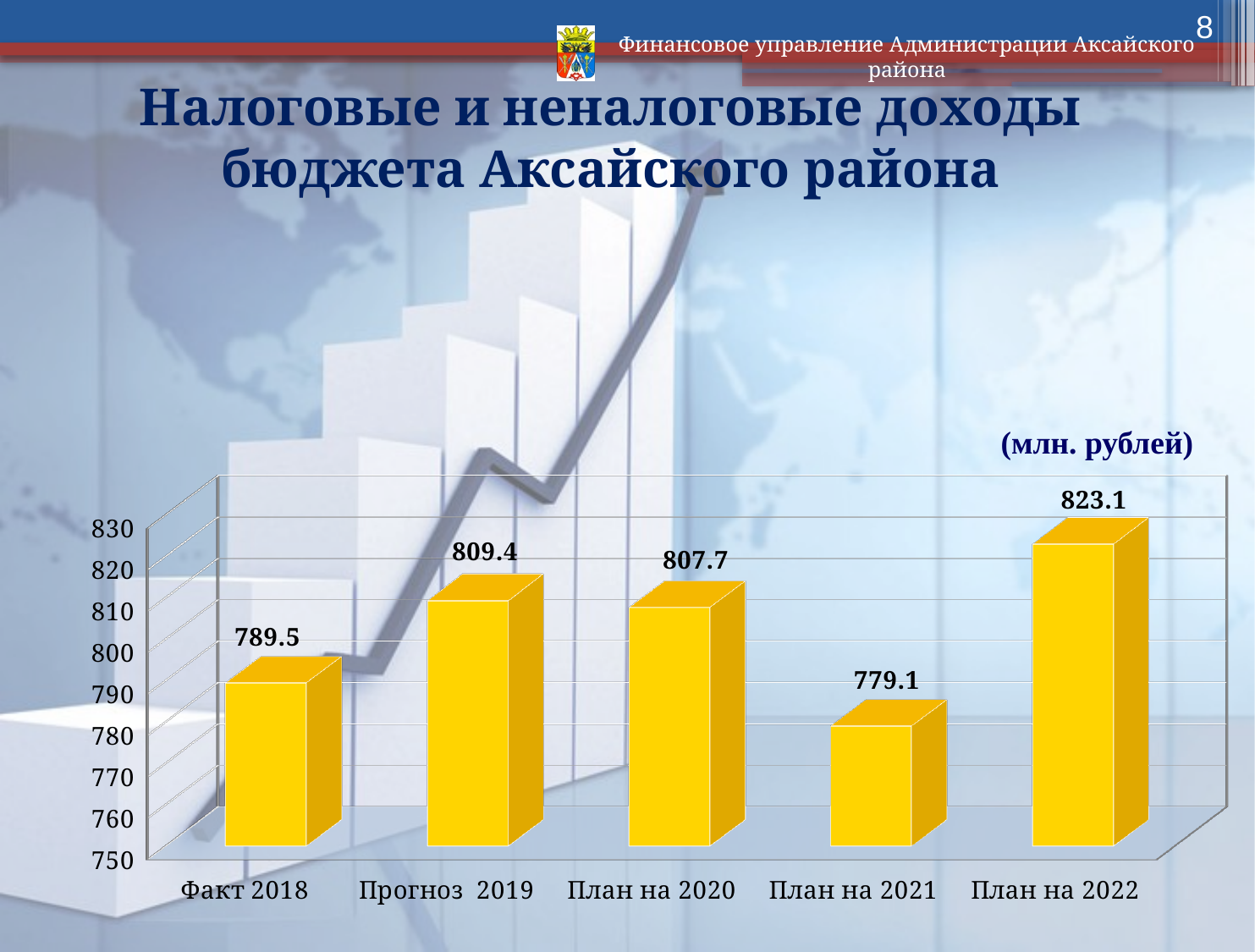
Which category has the highest value? План на 2022 Which category has the lowest value? План на 2021 Is the value for План на 2021 greater or less than 780? less What is the difference between the values for Прогноз 2019 and Факт 2018? 19.9 What is the difference between the values for План на 2022 and План на 2021? 44.0 What unit is indicated for the values on the chart? млн. рублей Which is larger, the value for Прогноз 2019 or the value for План на 2020? Прогноз 2019 What is the value for План на 2021? 779.1 What is the value for План на 2022? 823.1 What kind of chart is shown on the slide? bar chart What is the value for Факт 2018? 789.5 How many categories are shown on the x axis? 5